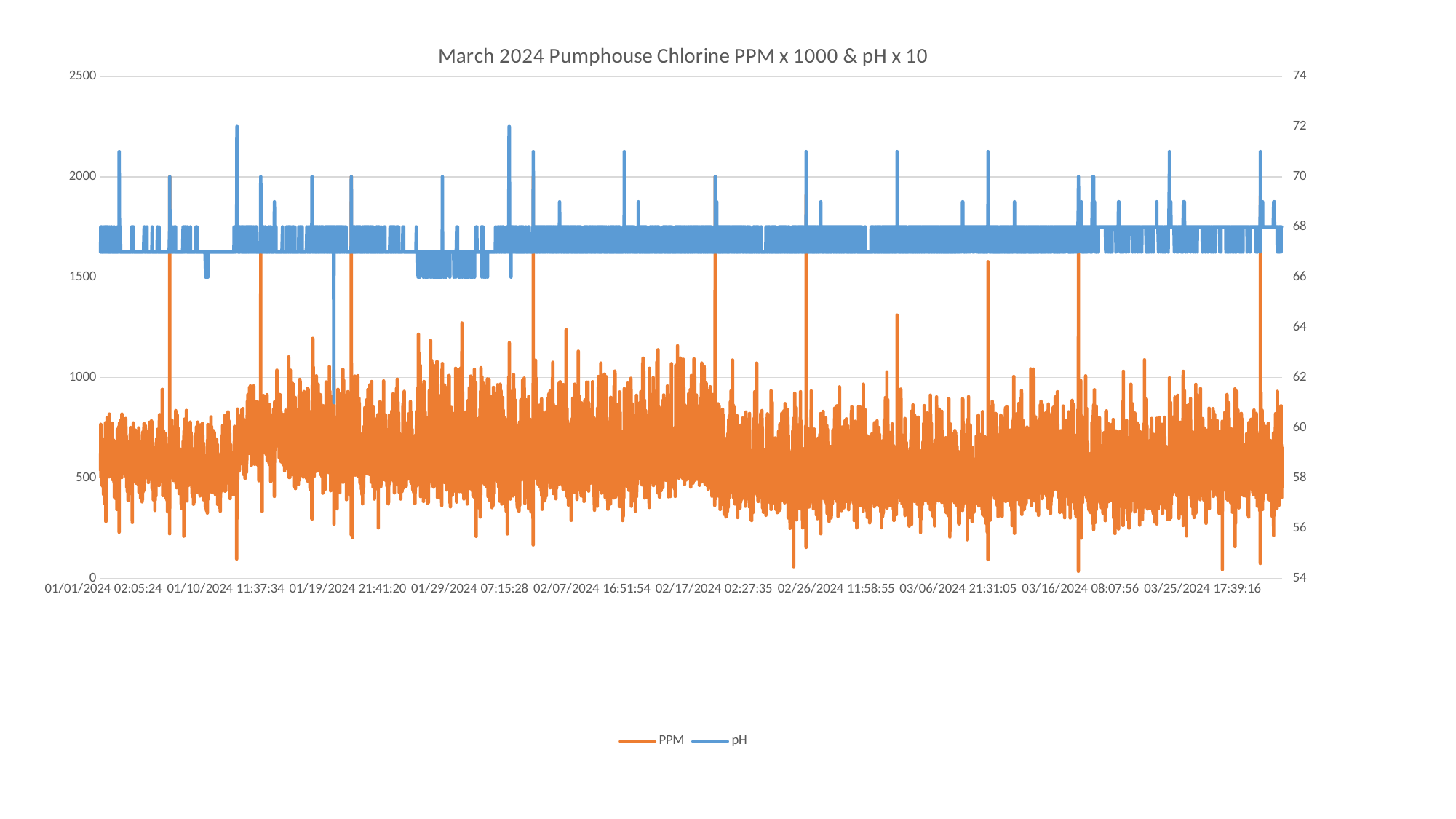
What is the title of the chart? March 2024 Pumphouse Chlorine PPM x 1000 & pH x 10 Is the highest spike of the pH series greater or less than 70 on the right axis? greater What is the lowest value shown on the right vertical axis? 54 What is the highest value shown on the right vertical axis? 74 Which series is drawn in orange? PPM How many series does the legend list? 2 Is the lowest dip of the PPM series greater or less than 500 on the left axis? less What is the first date label shown on the horizontal axis? 01/01/2024 02:05:24 Is the level at which the pH series sits for most of the period greater or less than 70 on the right axis? less What kind of chart is shown on the slide? line chart What is the highest value shown on the left vertical axis? 2500